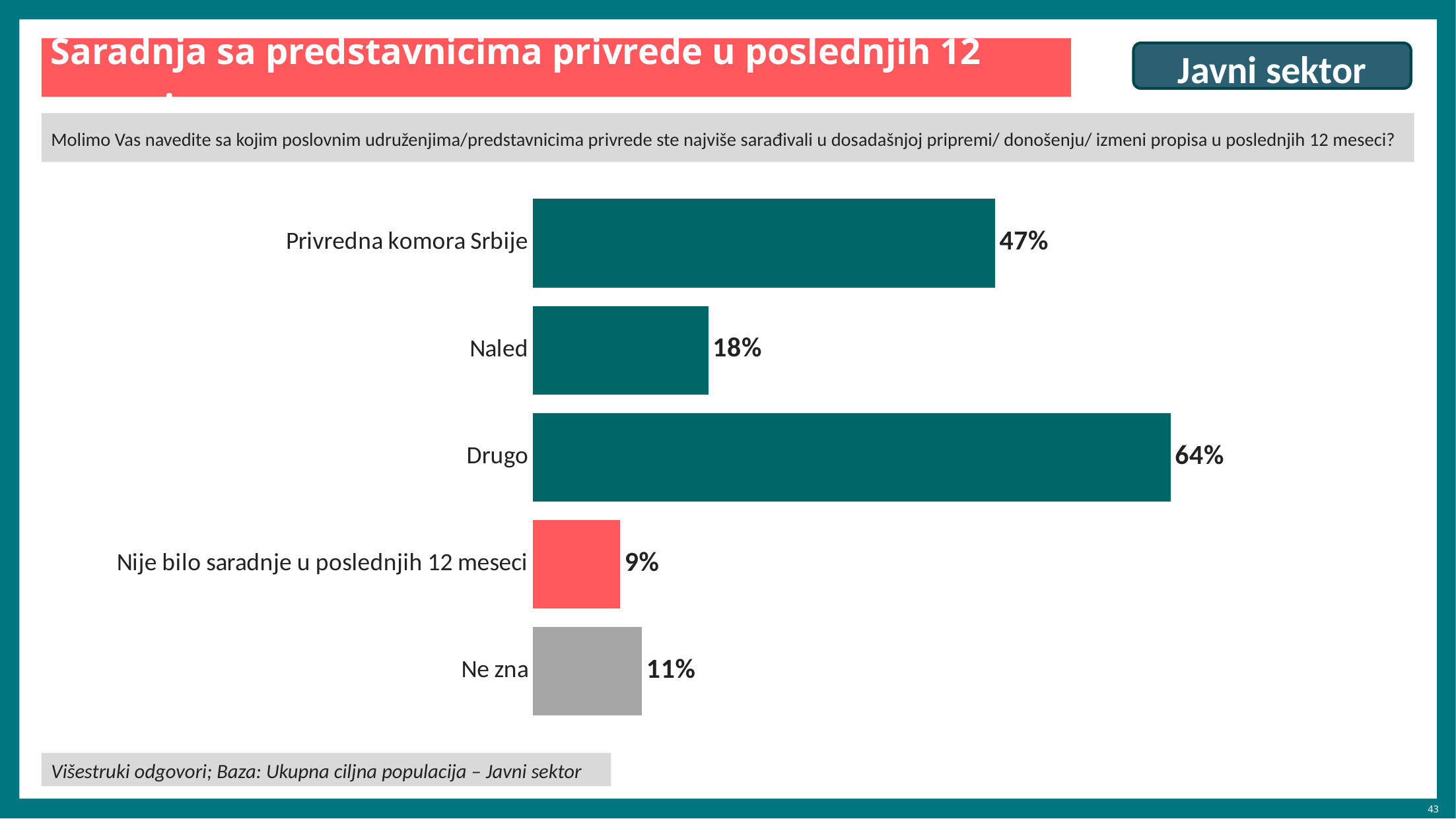
What is the value for Naled? 18% What is the value for Nije bilo saradnje u poslednjih 12 meseci? 9% What is the value for Privredna komora Srbije? 47% Which category has the highest value? Drugo What is the value for Ne zna? 11% Which is larger, the value for Naled or the value for Ne zna? Naled What is the difference between the values for Drugo and Privredna komora Srbije? 17% How many categories are shown in the chart? 5 Which category has the lowest value? Nije bilo saradnje u poslednjih 12 meseci What is the value for Drugo? 64% What colour is the bar for Nije bilo saradnje u poslednjih 12 meseci? Red What kind of chart is shown on the slide? Bar chart